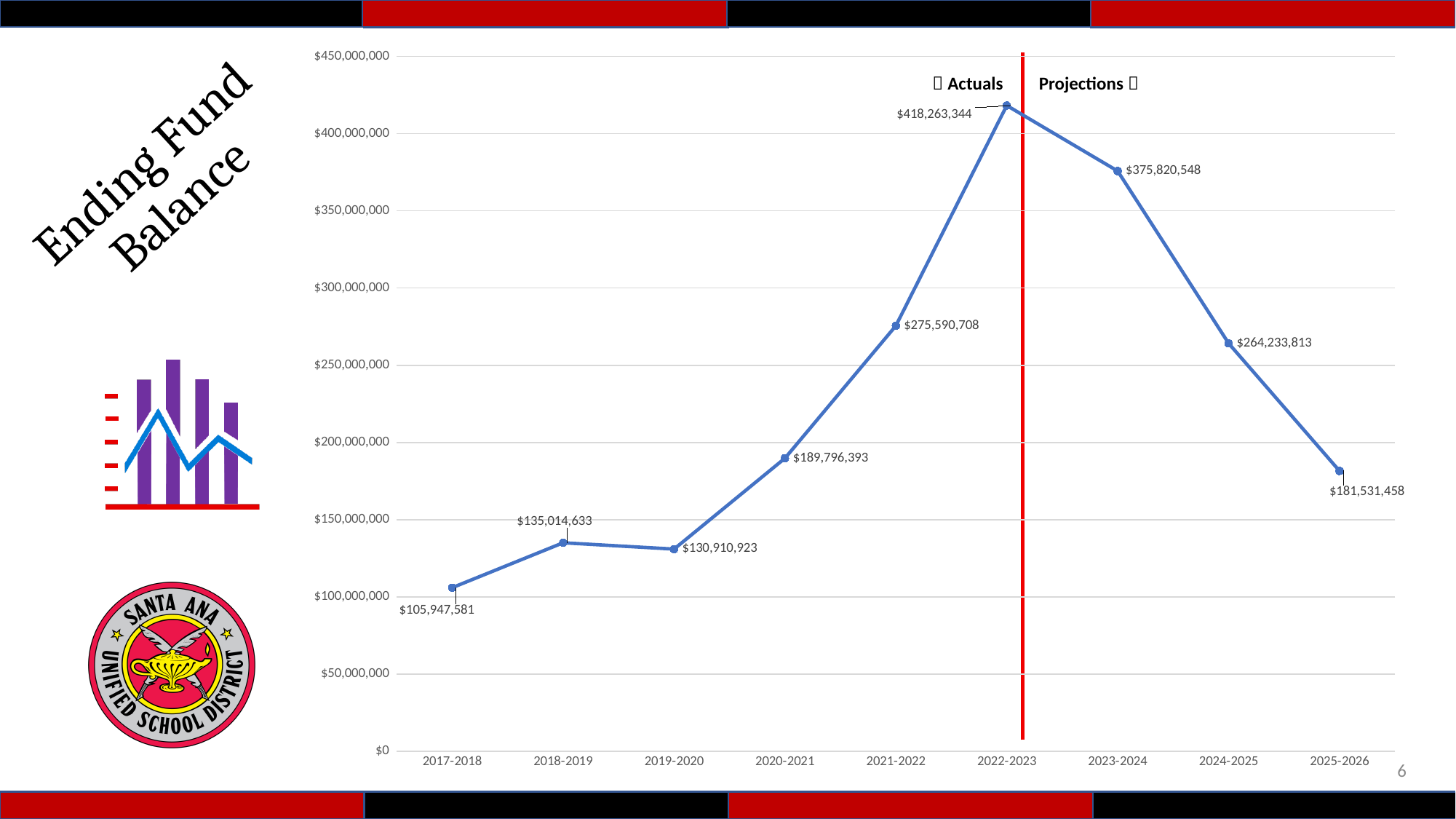
Do the values rise or fall from 2022-2023 to 2025-2026? fall What kind of chart is shown on the slide? line chart How many fiscal years are plotted on the chart? 9 What is the difference between the ending fund balance for 2022-2023 and 2023-2024? $42,442,796 What is the difference between the ending fund balance for 2018-2019 and 2019-2020? $4,103,710 Which is larger, the ending fund balance for 2021-2022 or for 2024-2025? 2021-2022 What is the projected ending fund balance for 2025-2026? $181,531,458 Which year has the lowest ending fund balance? 2017-2018 What is the ending fund balance for 2017-2018? $105,947,581 Is the ending fund balance for 2021-2022 greater or less than $250,000,000? greater Which year has the highest ending fund balance? 2022-2023 What is the ending fund balance for 2022-2023? $418,263,344